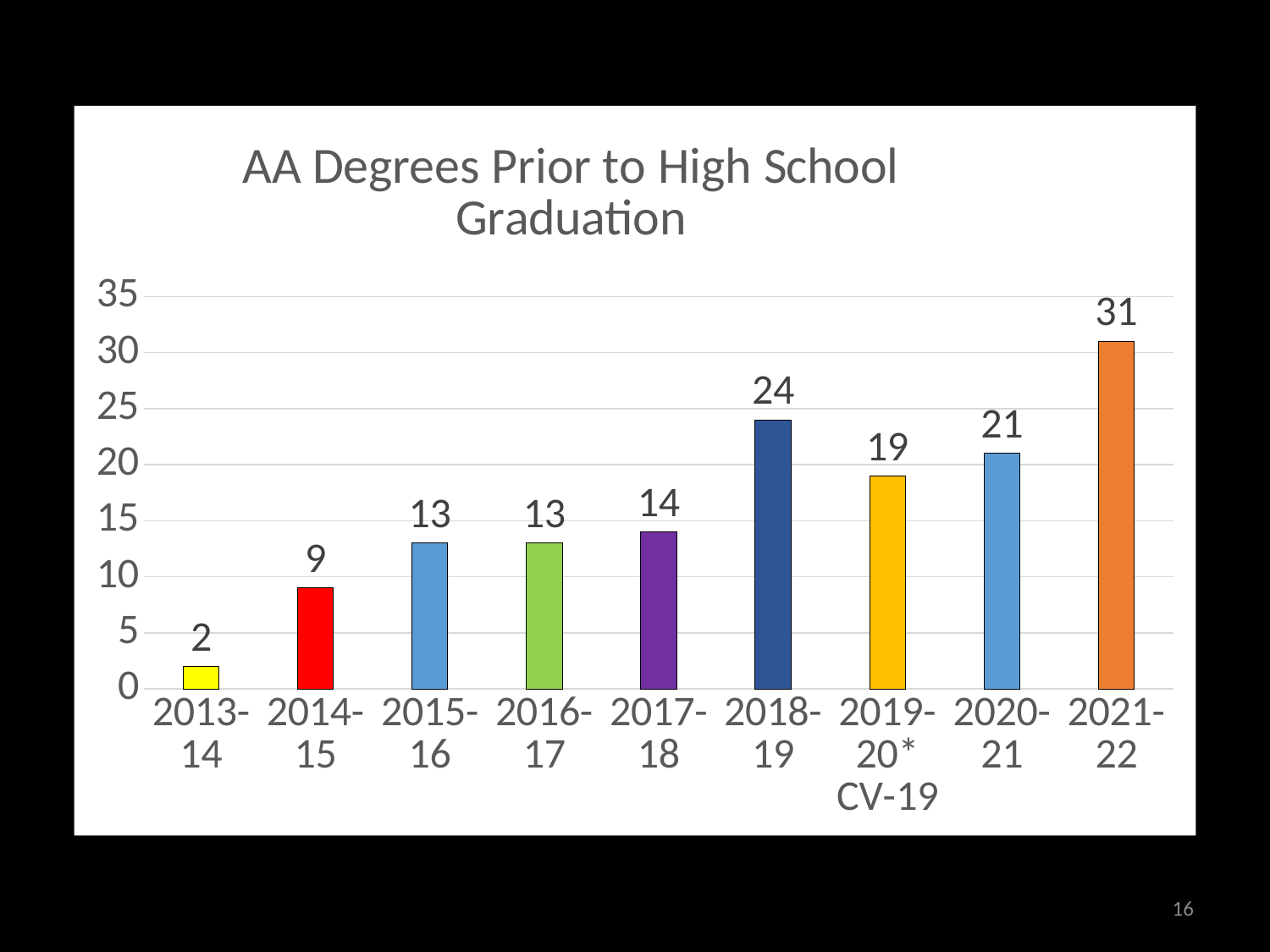
What is the value for 2013-14? 2 What is the title of the chart? AA Degrees Prior to High School Graduation What is the value for 2019-20* CV-19? 19 How many years are shown on the x axis? 9 What is the difference between the values for 2018-19 and 2019-20* CV-19? 5 What kind of chart is this? bar chart Is the value for 2017-18 greater or less than 10? greater Which year has the highest value? 2021-22 What is the value for 2021-22? 31 What is the difference between the values for 2021-22 and 2020-21? 10 Which is larger, the value for 2018-19 or the value for 2020-21? 2018-19 Which year has the lowest value? 2013-14